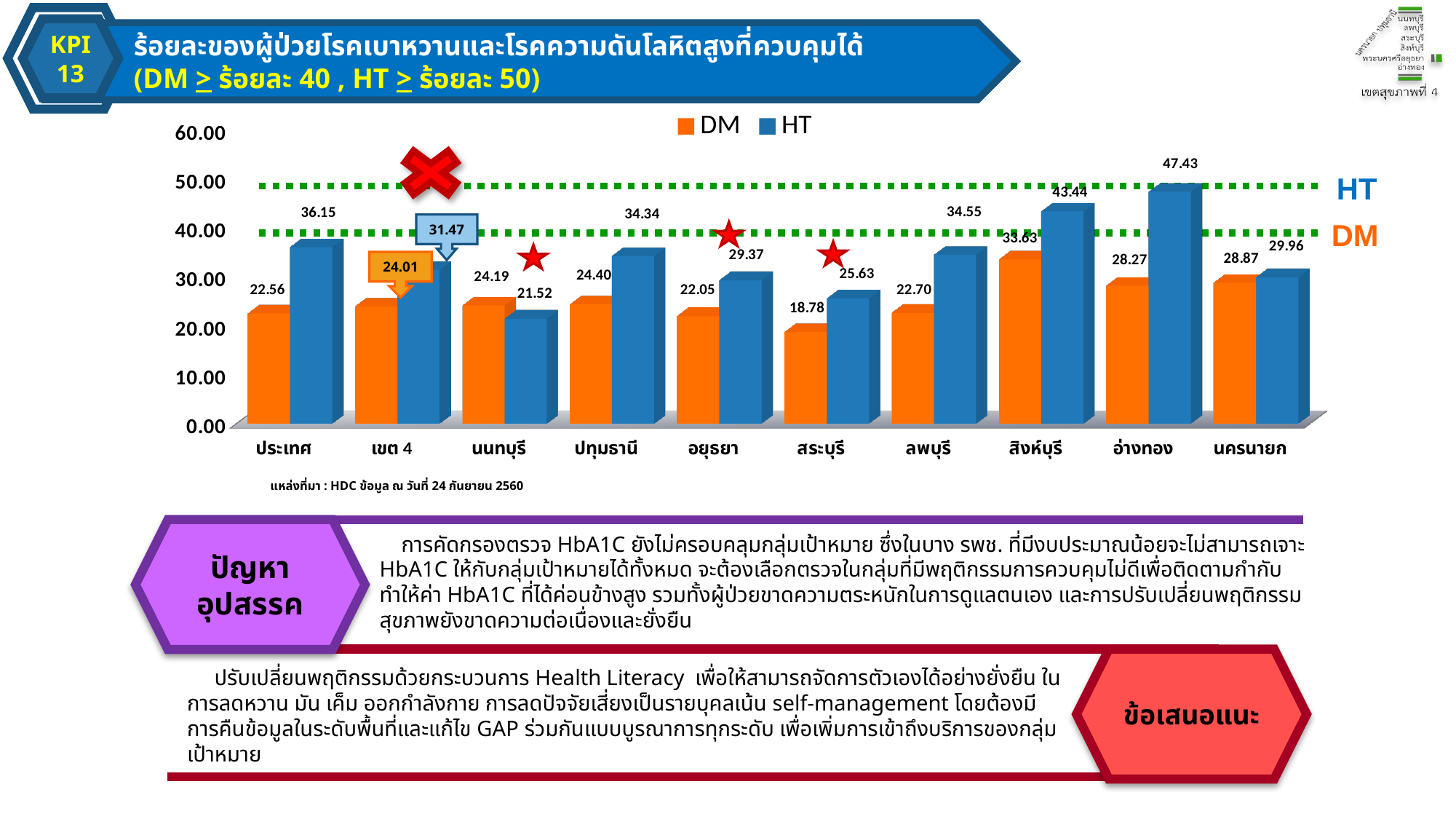
What kind of chart is shown on the slide? Bar chart What is the difference between the HT and DM values for อ่างทอง? 19.16 How many series does the legend list? 2 What is the HT value for เขต 4? 31.47 Which category has the lowest HT value? นนทบุรี What is the DM value for สระบุรี? 18.78 How many categories are shown on the x axis? 10 What is the HT value for อ่างทอง? 47.43 Which category has the highest HT value? อ่างทอง Which category has the lowest DM value? สระบุรี What is the DM value for สิงห์บุรี? 33.63 For นนทบุรี, which is larger, the DM value or the HT value? DM